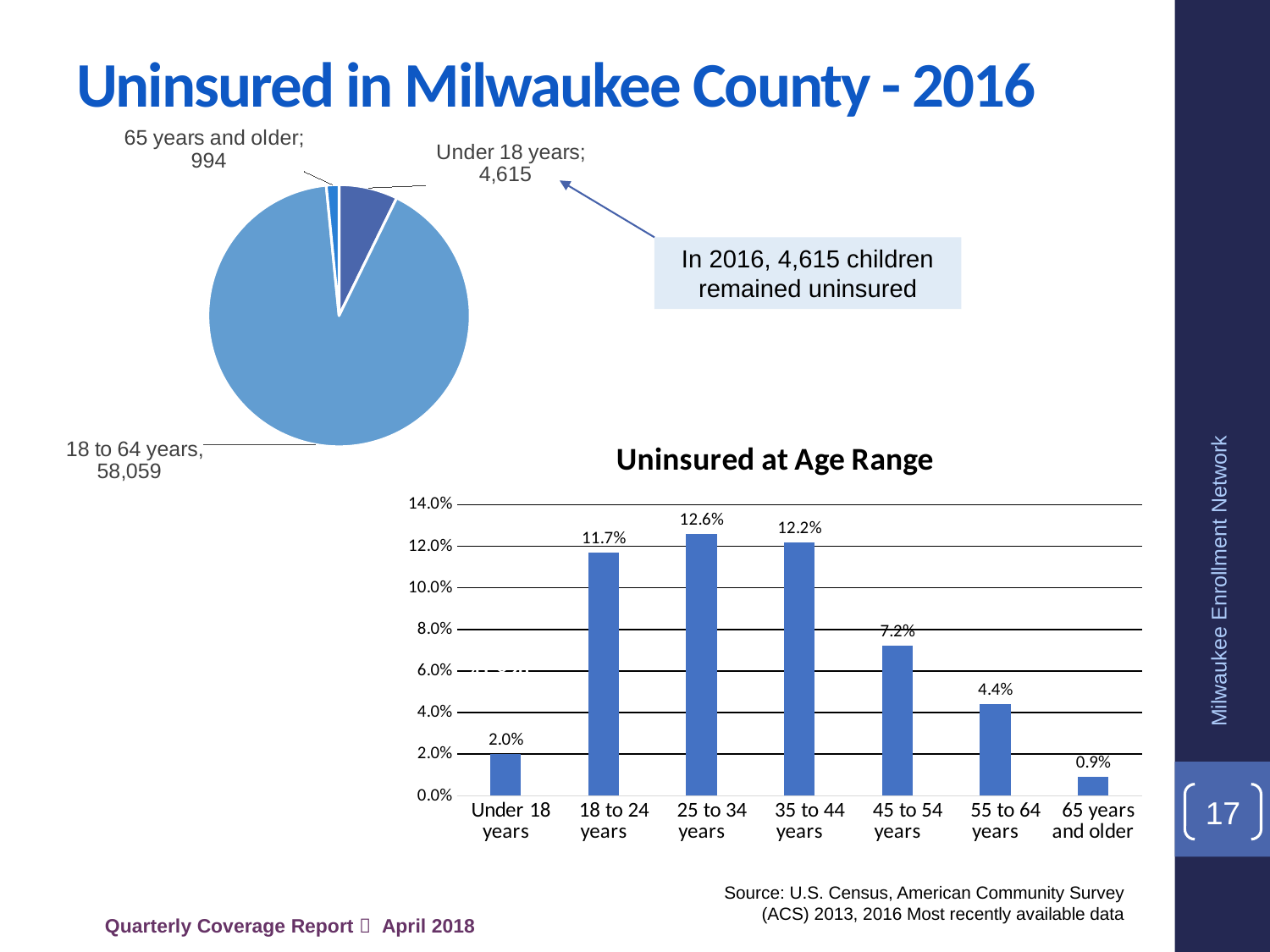
In the bar chart titled 'Uninsured at Age Range', what is the value for 25 to 34 years? 12.6% In the bar chart titled 'Uninsured at Age Range', which age range has the lowest value? 65 years and older In the pie chart at the top left of the slide, which category has the largest slice? 18 to 64 years What kind of chart is the 'Uninsured at Age Range' chart? Bar chart In the pie chart at the top left of the slide, what is the difference between the values for 18 to 64 years and Under 18 years? 53,444 In the pie chart at the top left of the slide, what is the value for 18 to 64 years? 58,059 In the bar chart titled 'Uninsured at Age Range', which age range has the highest value? 25 to 34 years In the bar chart titled 'Uninsured at Age Range', which is larger, the value for 45 to 54 years or the value for 55 to 64 years? 45 to 54 years In the pie chart at the top left of the slide, what is the value for 65 years and older? 994 In the bar chart titled 'Uninsured at Age Range', what is the value for 55 to 64 years? 4.4% In the bar chart titled 'Uninsured at Age Range', how many age ranges are shown? 7 In the bar chart titled 'Uninsured at Age Range', what is the difference between the values for 25 to 34 years and 18 to 24 years? 0.9%